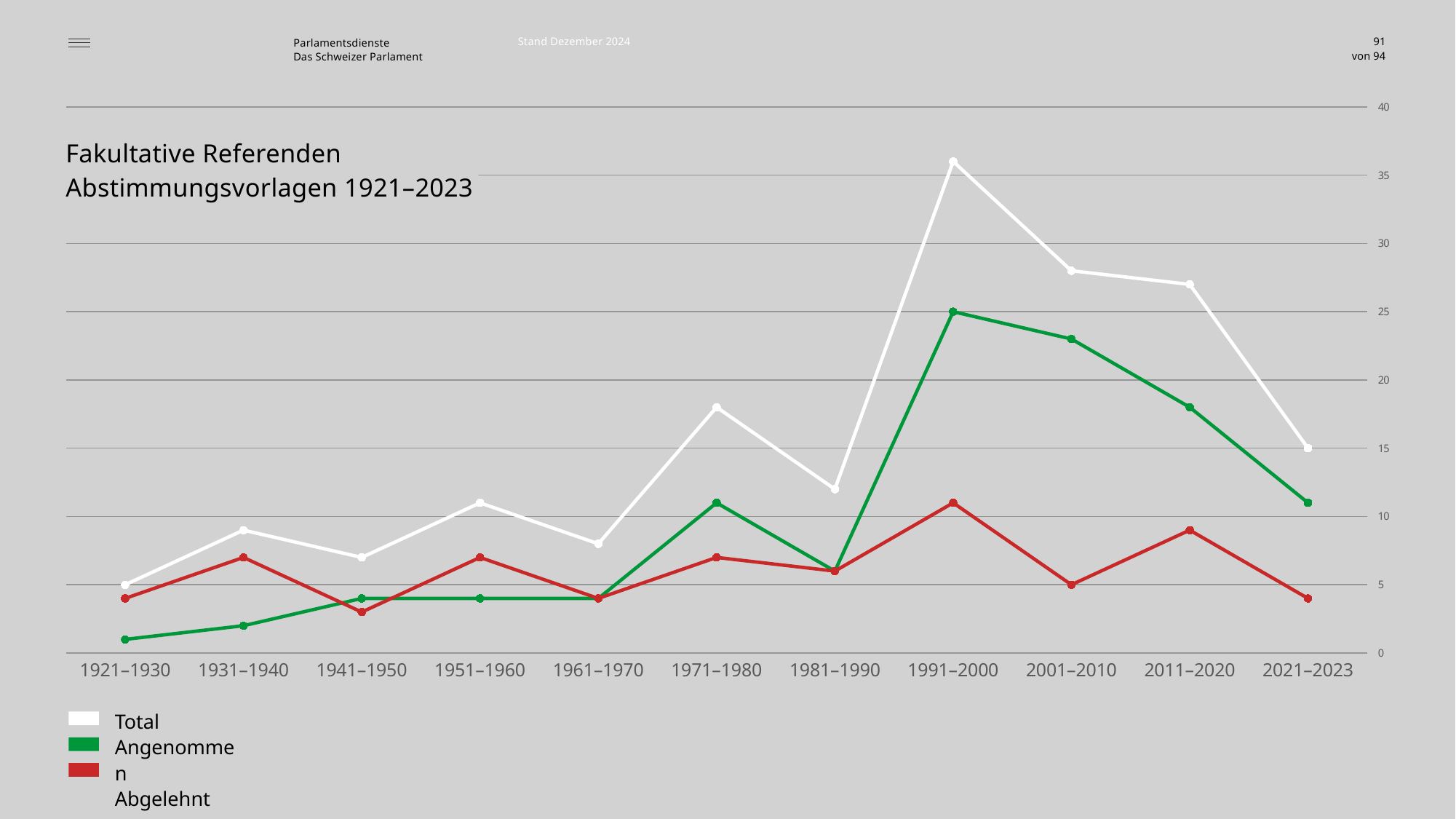
How many series does the legend list? 3 Is the Total value for 1991–2000 greater or less than 35? greater In which period is the Total series highest? 1991–2000 Is the Abgelehnt value for 2011–2020 greater or less than 10? less What is the Total value for 2021–2023? 15 What kind of chart is shown on the slide? line chart How many periods are shown along the x axis? 11 What is the Angenommen value for 1991–2000? 25 What is the Total value for 1921–1930? 5 Which is larger in 2001–2010, Angenommen or Abgelehnt? Angenommen Does the Total series rise or fall from 1991–2000 to 2021–2023? fall In which period is the Angenommen series lowest? 1921–1930